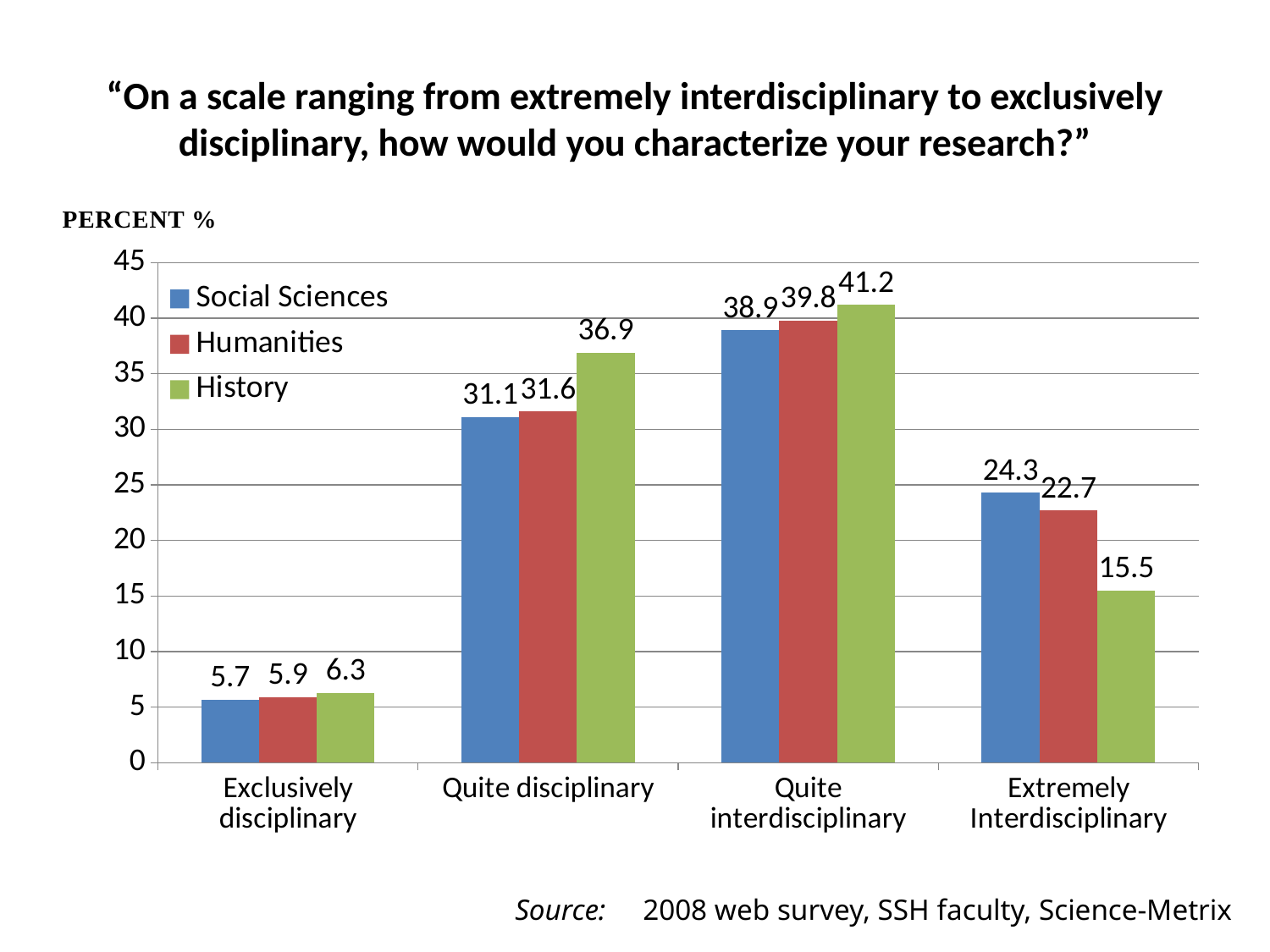
What is the label on the y axis? PERCENT % Is the value for Humanities in the Quite interdisciplinary category greater or less than 35? greater What kind of chart is shown on the slide? bar chart What is the value for History in the Quite disciplinary category? 36.9 What is the value for Humanities in the Exclusively disciplinary category? 5.9 What is the difference between the History and Social Sciences values in the Extremely Interdisciplinary category? 8.8 How many categories are shown on the x axis? 4 What is the value for Social Sciences in the Extremely Interdisciplinary category? 24.3 Which category has the lowest value for Social Sciences? Exclusively disciplinary Which category has the highest value for History? Quite interdisciplinary How many series does the legend list? 3 In the Quite disciplinary category, which is larger: the Social Sciences value or the History value? History